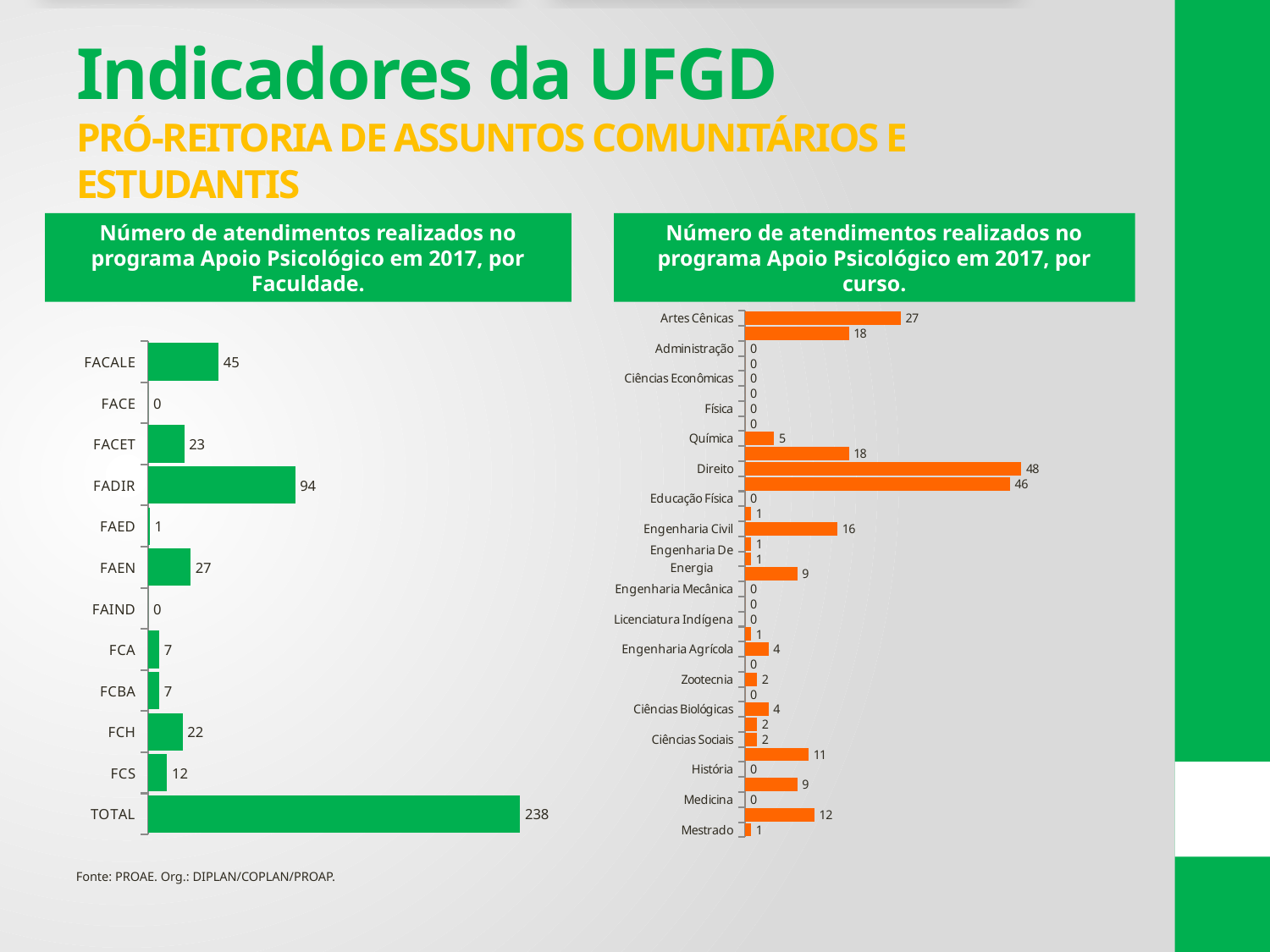
In the left chart (por Faculdade), what is the value for FACALE? 45 In the right chart (por curso), what is the value labelled for Artes Cênicas? 27 What colour are the bars in the right chart (por curso)? Orange In the left chart (por Faculdade), what is the value for FADIR? 94 What type of chart is the left chart (por Faculdade)? Bar chart In the left chart (por Faculdade), which is larger, FACET or FAEN? FAEN In the left chart (por Faculdade), what is the difference between FADIR and FACALE? 49 In the left chart (por Faculdade), what is the TOTAL value? 238 In the left chart (por Faculdade), what is the value for FCH? 22 In the left chart (por Faculdade), excluding TOTAL, which faculdade has the highest number of atendimentos? FADIR In the right chart (por curso), what is the value labelled for Direito? 48 In the left chart (por Faculdade), how many categories are shown, including TOTAL? 12